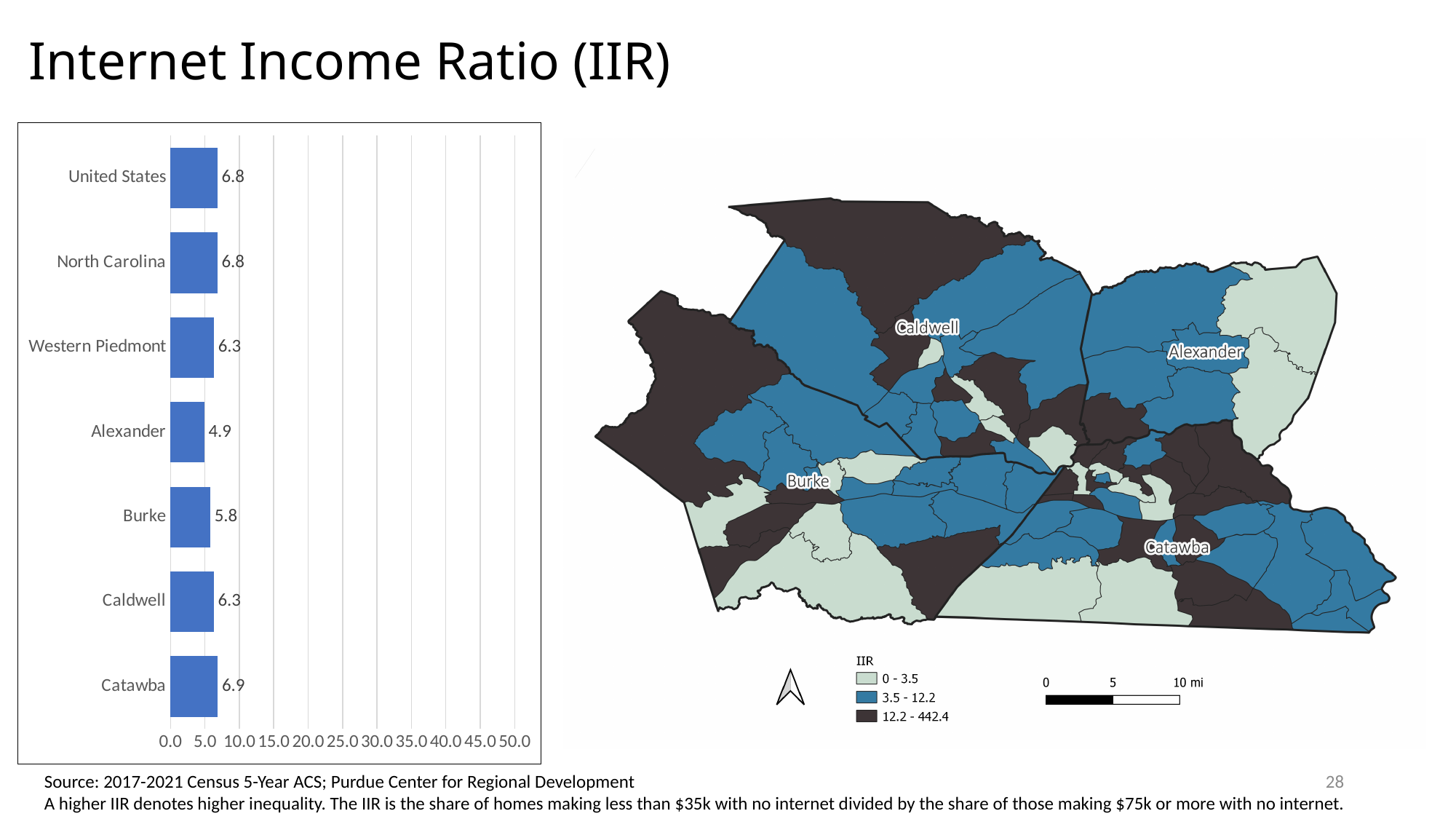
What is the IIR value for Alexander in the bar chart? 4.9 Which category has the highest IIR value in the bar chart? Catawba How many categories are shown in the bar chart? 7 What is the IIR value for Catawba in the bar chart? 6.9 What is the IIR value for Western Piedmont in the bar chart? 6.3 What is the IIR value for Burke in the bar chart? 5.8 What is the highest value shown on the x axis of the bar chart? 50.0 What is the difference between the IIR values for Catawba and Alexander in the bar chart? 2.0 What type of chart is shown on the left of the slide? Bar chart Which has a higher IIR value in the bar chart, Burke or Caldwell? Caldwell Is the IIR value for North Carolina in the bar chart greater or less than 10.0? less Which category has the lowest IIR value in the bar chart? Alexander